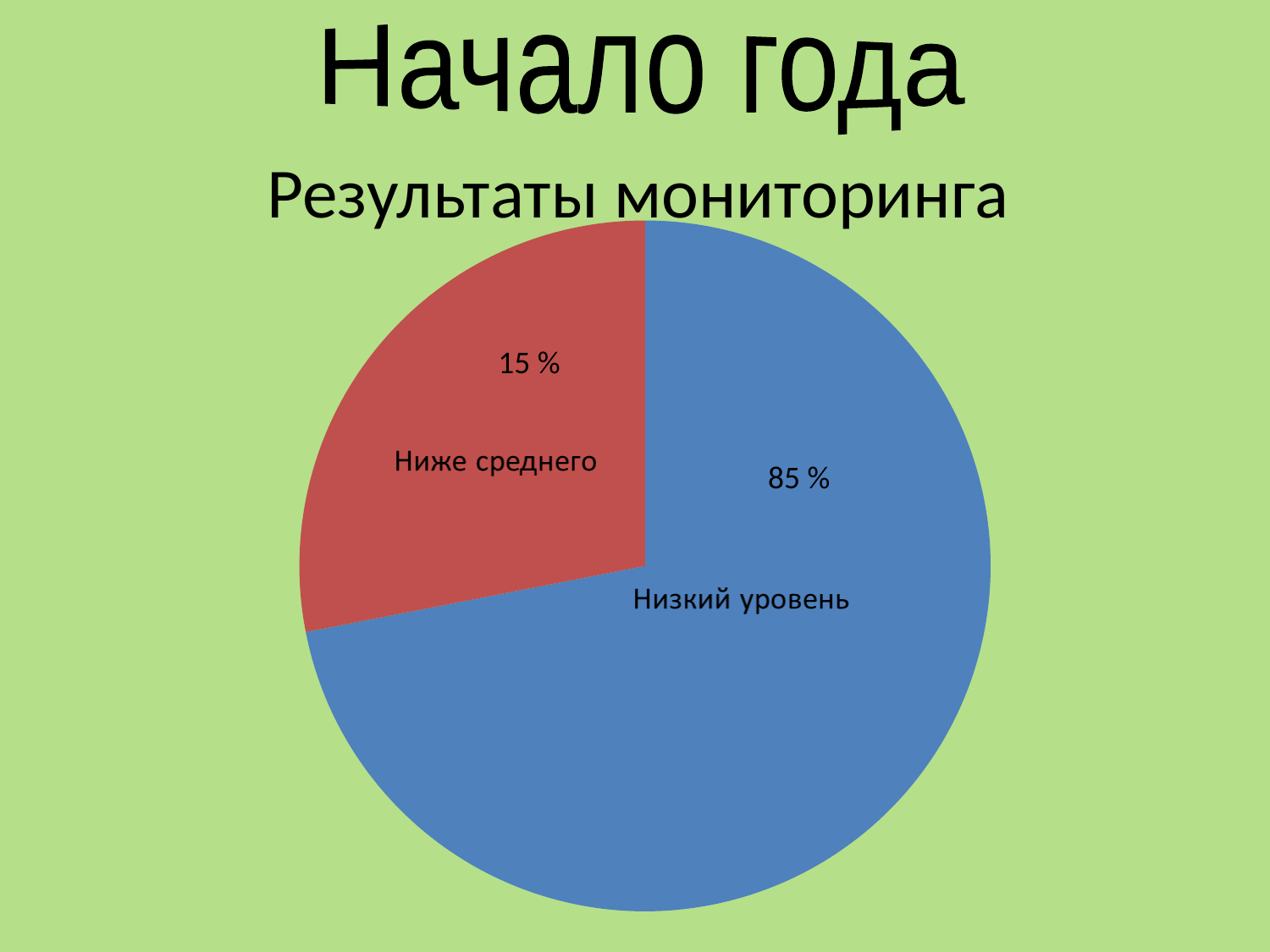
What kind of chart is shown on the slide? pie chart What share of the pie does "Ниже среднего" take? 15 % What is the value for "Ниже среднего"? 15 % What colour is the slice for "Ниже среднего"? red What is the value for "Низкий уровень"? 85 % How many slices does the pie chart have? 2 Which category has the largest slice? Низкий уровень Which is larger, the slice for "Низкий уровень" or the slice for "Ниже среднего"? Низкий уровень What is the difference between the values for "Низкий уровень" and "Ниже среднего"? 70 % What is the title of the chart? Результаты мониторинга Which category has the smallest slice? Ниже среднего